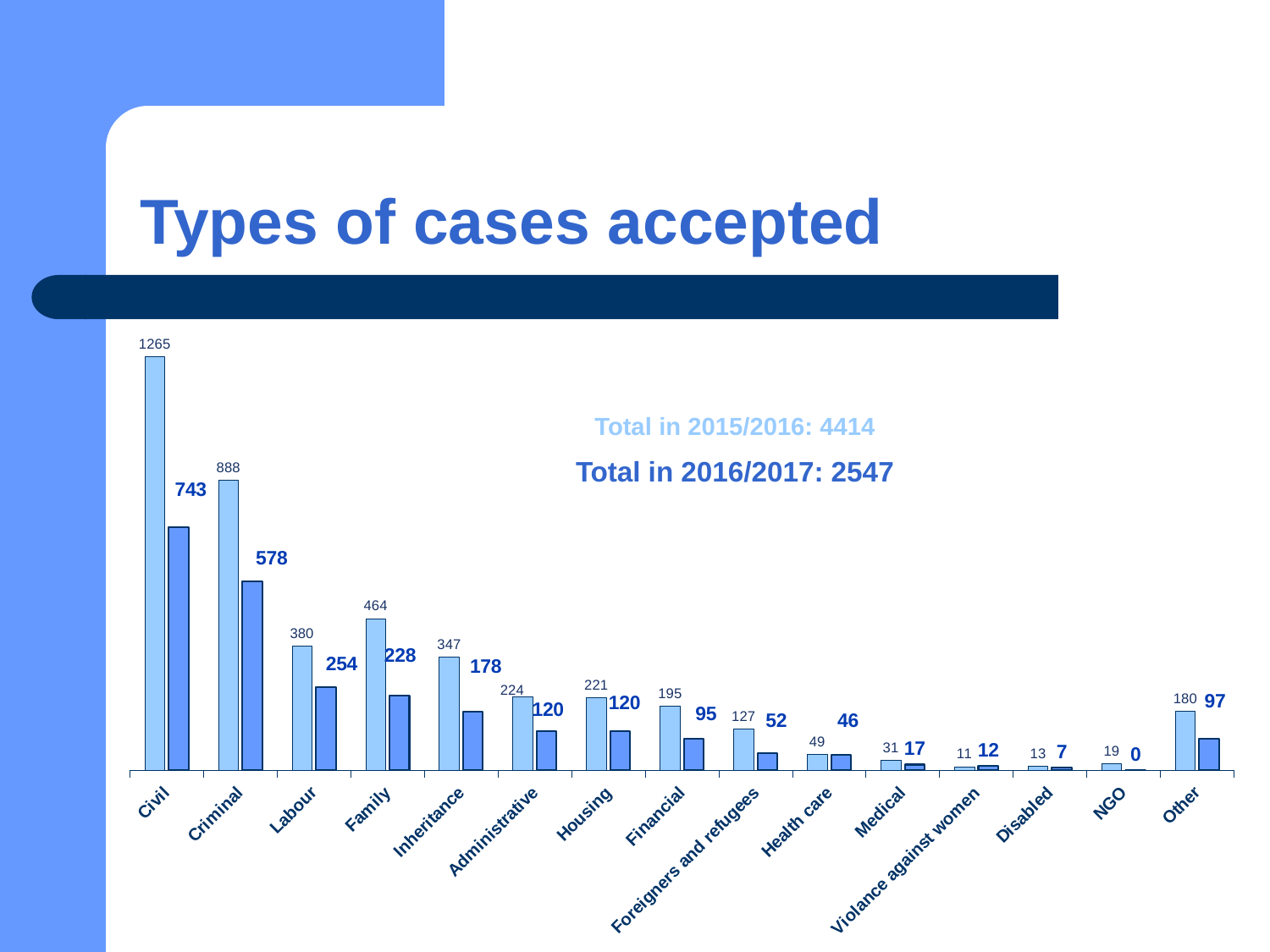
What is the title of the slide? Types of cases accepted What kind of chart is shown on the slide? Bar chart What is the 2015/2016 value for Civil cases? 1265 Which is larger: the 2015/2016 value for Labour or the 2015/2016 value for Family? Family What is the 2016/2017 value for NGO cases? 0 How many case categories are shown on the x axis? 15 What is the 2016/2017 value for Criminal cases? 578 What is the total number of cases accepted in 2016/2017 according to the slide? 2547 What is the difference between the 2015/2016 and 2016/2017 values for Family cases? 236 Which category has the lowest 2016/2017 value? NGO Which category has the highest 2015/2016 value? Civil What is the 2015/2016 value for Other cases? 180